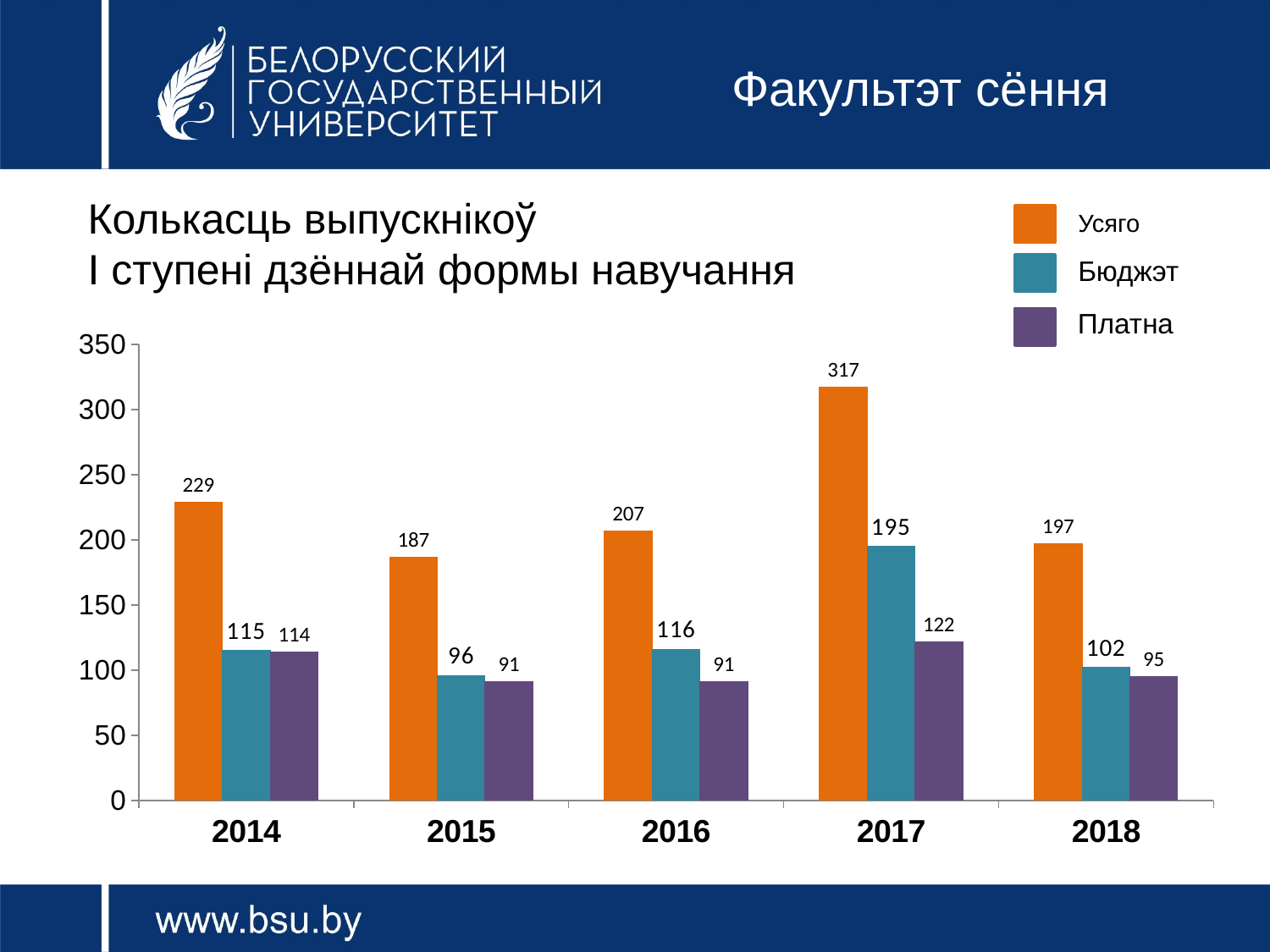
What is the value of Платна for 2018? 95 What is the value of Бюджэт for 2015? 96 Which year has the highest Усяго value? 2017 How many years are shown on the x axis? 5 How many series does the legend list? 3 Which year has the lowest Усяго value? 2015 Which colour represents the Платна series in the legend? purple What is the difference between Усяго in 2017 and Усяго in 2018? 120 What is the value of Усяго for 2017? 317 Which is larger: Бюджэт in 2014 or Бюджэт in 2016? Бюджэт in 2016 What kind of chart is shown on the slide? bar chart Is the value of Усяго for 2016 greater or less than 200? greater